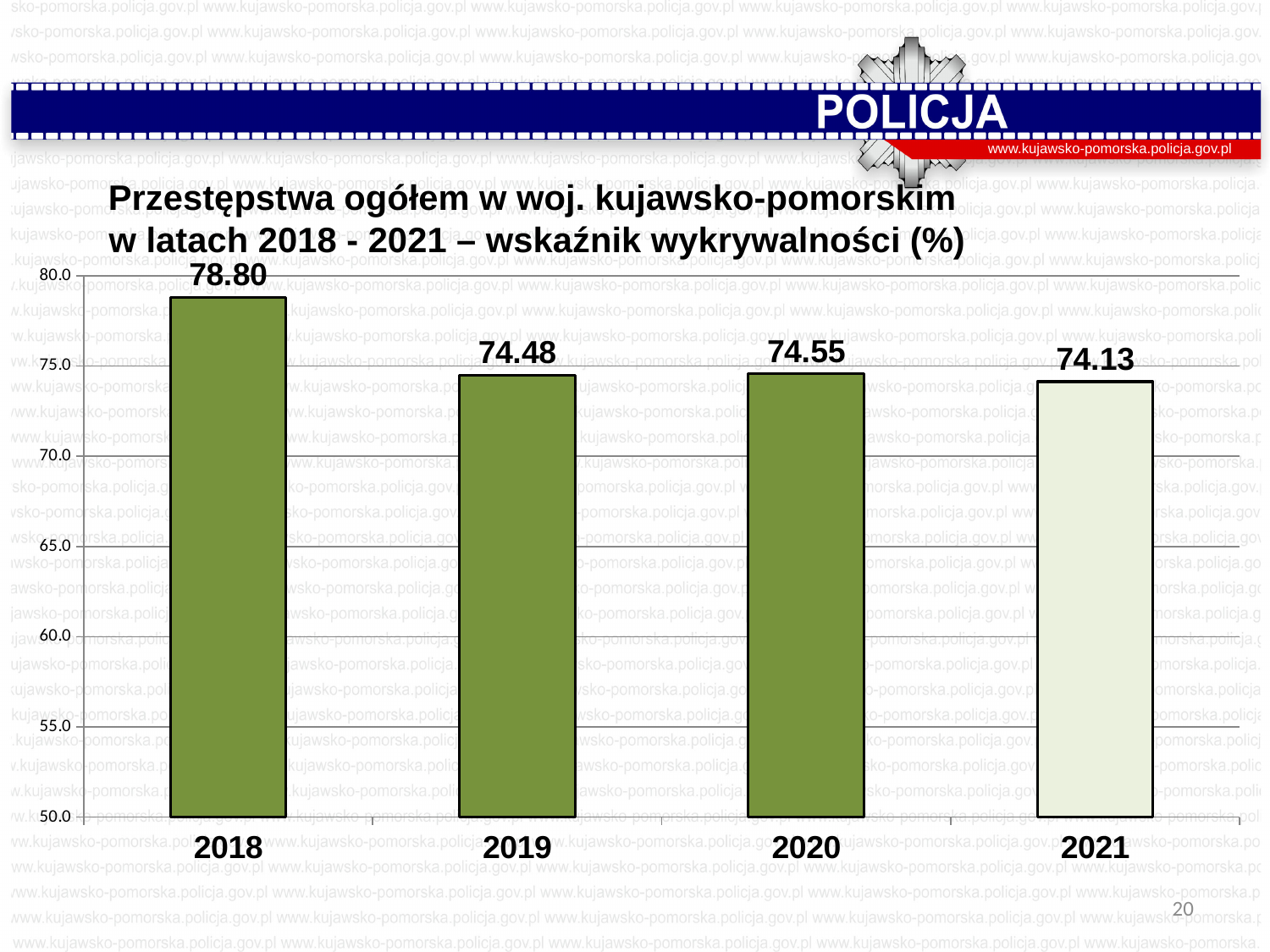
What value is shown for 2019? 74.48 What is the difference between the values for 2018 and 2021? 4.67 Is the value for 2020 greater or less than 75.0? less Which year has the lowest value? 2021 Which is larger, the value for 2018 or the value for 2020? 2018 What is the detection rate (wskaźnik wykrywalności) shown for 2018? 78.80 Does the value rise or fall from 2018 to 2019? fall What value is shown for 2021? 74.13 What kind of chart is shown on the slide? bar chart What is the difference between the values for 2020 and 2019? 0.07 Which year has the highest value? 2018 How many years are shown on the x axis? 4